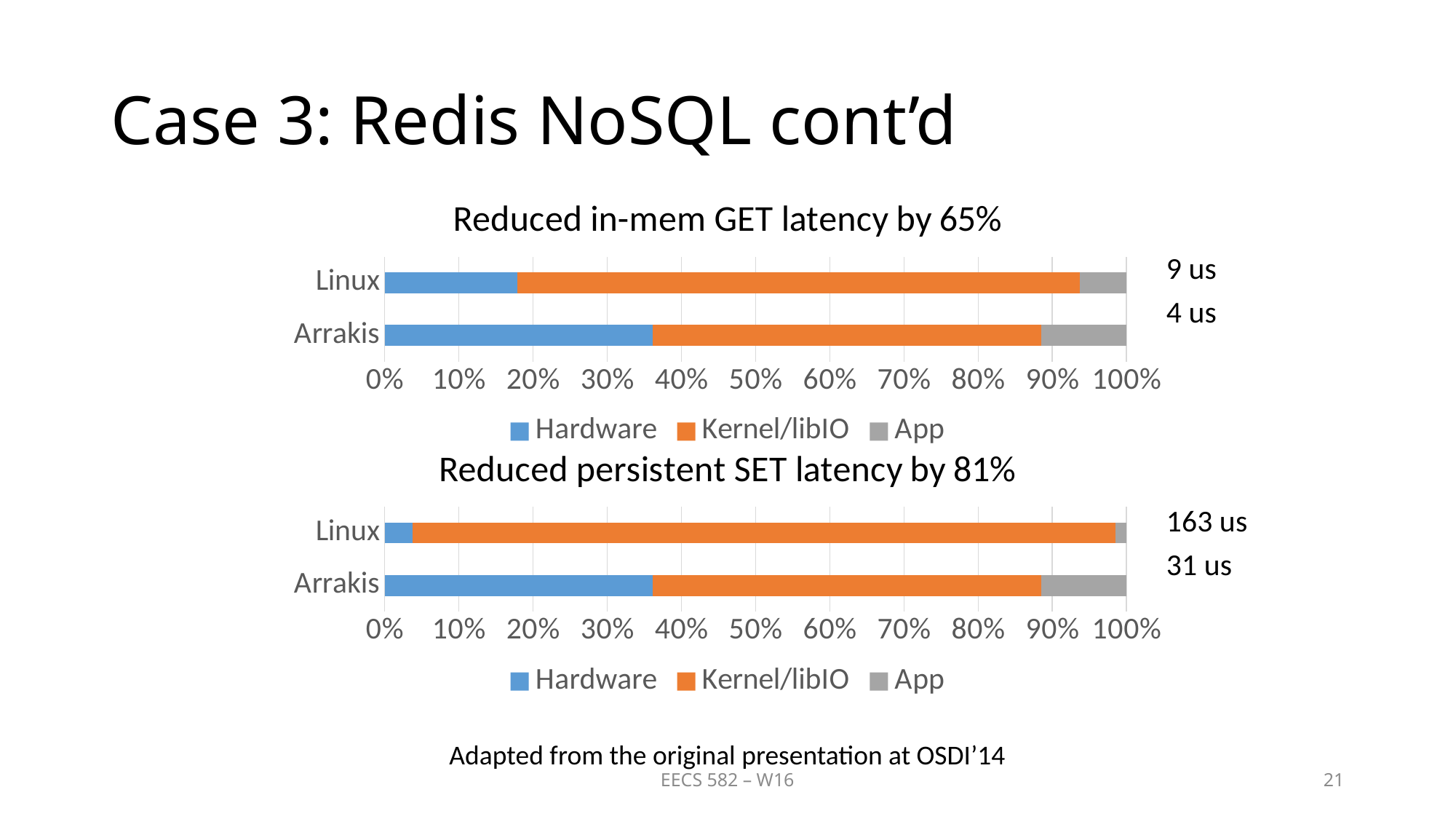
How many series does the legend of the top chart list? 3 In the bottom chart, what latency is printed next to the Arrakis bar? 31 us In the top chart, is the Hardware share of the Linux bar greater or less than 20%? less In the top chart, what latency is printed next to the Arrakis bar? 4 us In the top chart, which has the larger Hardware share, Linux or Arrakis? Arrakis How many categories are shown on the y axis of the bottom chart, 'Reduced persistent SET latency by 81%'? 2 In the bottom chart, is the Hardware share of the Linux bar greater or less than 10%? less In the bottom chart, what latency is printed next to the Linux bar? 163 us In the bottom chart, which has the larger Kernel/libIO share, Linux or Arrakis? Linux What kind of chart is the top chart, 'Reduced in-mem GET latency by 65%'? bar chart In the top chart, what latency is printed next to the Linux bar? 9 us What is the title of the bottom chart? Reduced persistent SET latency by 81%